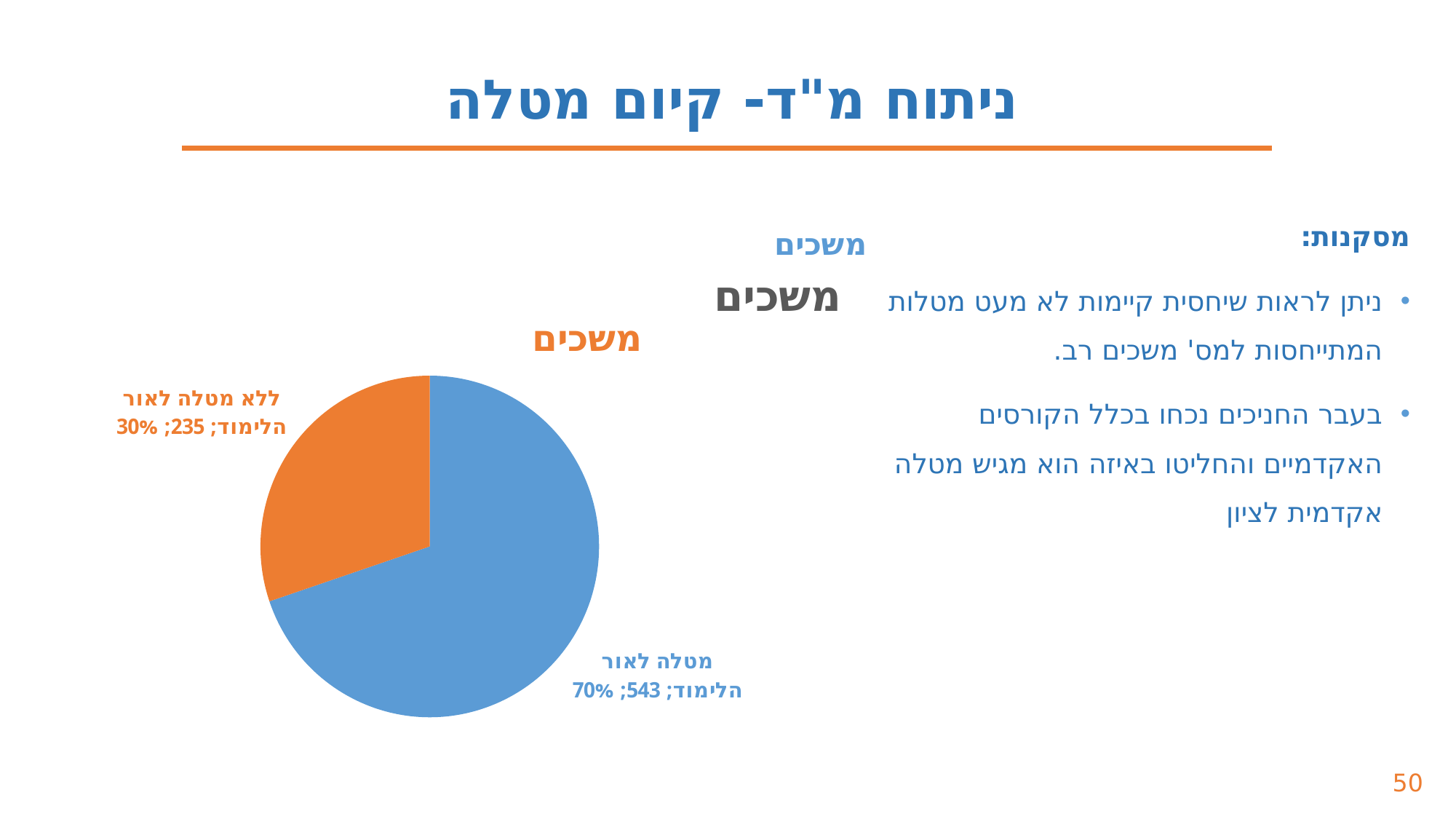
What is the total of the two values shown in the pie chart? 778 What is the value shown for the slice labelled "מטלה לאור הלימוד"? 543 How many slices does the pie chart have? 2 What is the value shown for the slice labelled "ללא מטלה לאור הלימוד"? 235 What percentage share does the slice "ללא מטלה לאור הלימוד" have? 30% Which is larger: the value for "מטלה לאור הלימוד" or the value for "ללא מטלה לאור הלימוד"? מטלה לאור הלימוד Which slice of the pie chart is the largest? מטלה לאור הלימוד What is the difference between the values for "מטלה לאור הלימוד" and "ללא מטלה לאור הלימוד"? 308 Which slice of the pie chart is the smallest? ללא מטלה לאור הלימוד What kind of chart is shown on the slide? pie chart What is the title of the pie chart? משכים What percentage share does the slice "מטלה לאור הלימוד" have? 70%